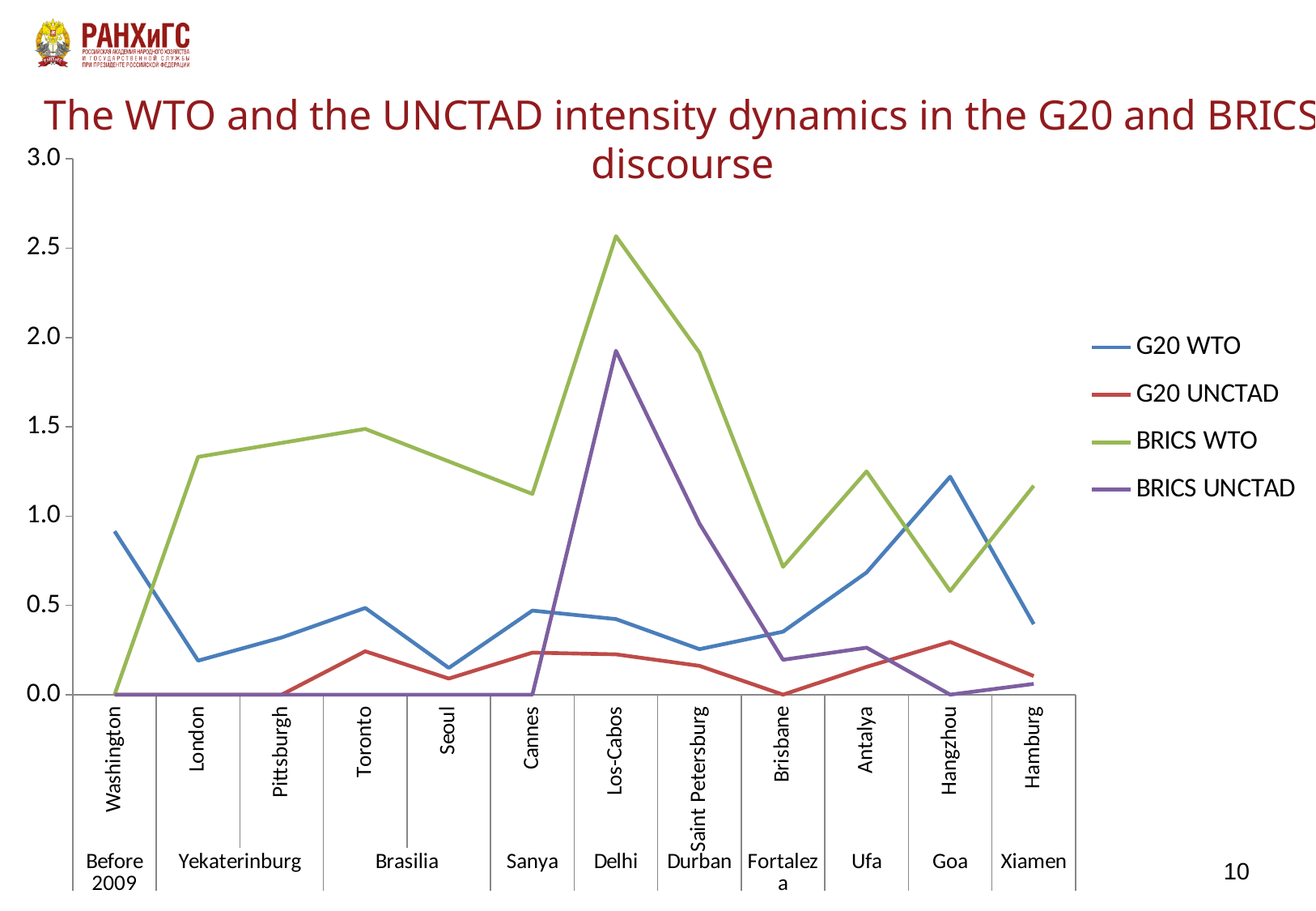
What kind of chart is shown on the slide? Line chart At which summit does the G20 WTO series reach its highest value? Hangzhou Is the G20 WTO value at Washington greater or less than 1.0? less How many summit categories are plotted along the x axis? 12 At which summit does the BRICS UNCTAD series reach its highest value? Los-Cabos What is the BRICS UNCTAD value at Washington? 0.0 At Hangzhou, which is larger: G20 WTO or BRICS WTO? G20 WTO At which summit does the BRICS WTO series reach its highest value? Los-Cabos Is the BRICS WTO value at Los-Cabos greater or less than 2.0? greater Is the BRICS UNCTAD value at Los-Cabos greater or less than 1.5? greater How many series does the legend list? 4 Does the G20 WTO series rise or fall from Hangzhou to Hamburg? Fall